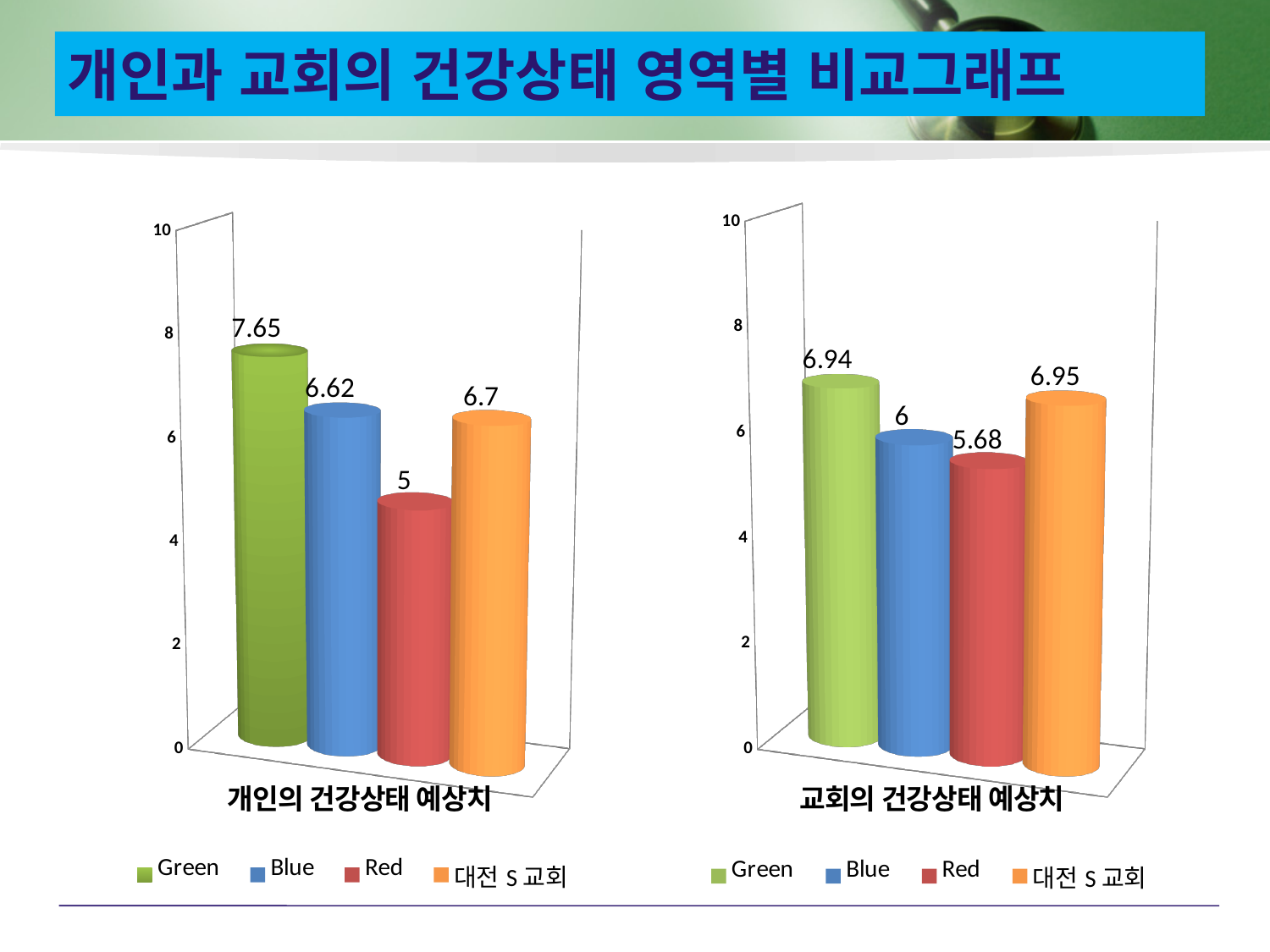
In the right chart (교회의 건강상태 예상치), what is the value for Blue? 6 In the left chart (개인의 건강상태 예상치), what is the value for Green? 7.65 In the left chart (개인의 건강상태 예상치), what is the difference between the Green value and the Red value? 2.65 In the left chart (개인의 건강상태 예상치), which series has the lowest value? Red In the left chart (개인의 건강상태 예상치), what is the value for 대전 S 교회? 6.7 In the right chart (교회의 건강상태 예상치), is the value for Blue larger or the value for Red? Blue In the left chart (개인의 건강상태 예상치), which series has the highest value? Green In the right chart (교회의 건강상태 예상치), what is the value for Red? 5.68 What kind of chart is the right chart (교회의 건강상태 예상치)? Bar chart How many series does the legend of the left chart (개인의 건강상태 예상치) list? 4 In the right chart (교회의 건강상태 예상치), which series has the lowest value? Red In the right chart (교회의 건강상태 예상치), is the value for Green greater or less than 6? greater